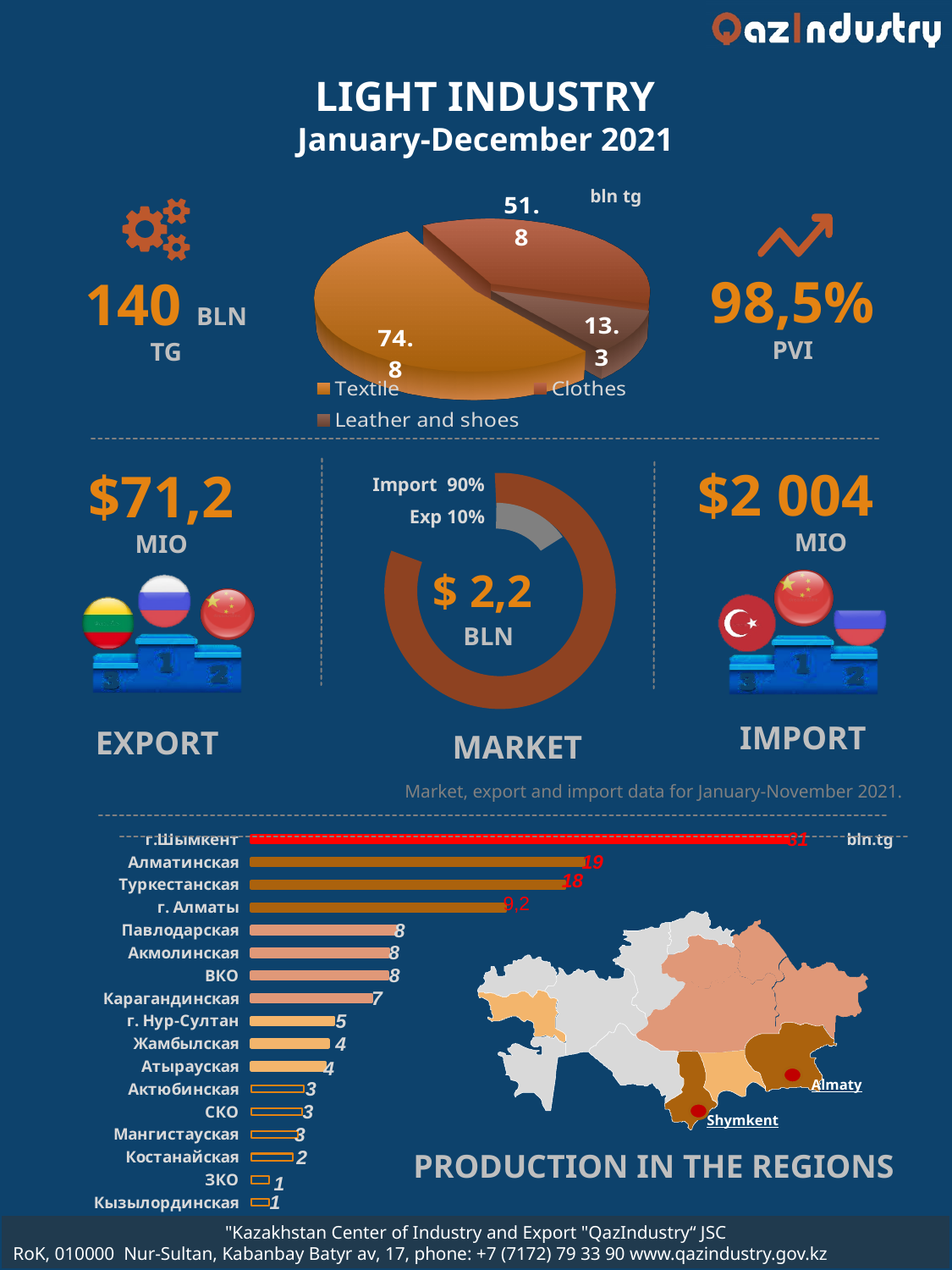
In the MARKET donut chart, what share is Exp? 10% In the pie chart at the top of the slide, how many categories does the legend list? 3 In the pie chart at the top of the slide, which category has the smallest slice? Leather and shoes In the pie chart at the top of the slide, what is the value for Leather and shoes? 13.3 In the pie chart at the top of the slide, what is the value for Textile? 74.8 What kind of chart is the PRODUCTION IN THE REGIONS chart? bar chart In the MARKET donut chart, what share is Import? 90% In the PRODUCTION IN THE REGIONS chart, which region has the highest value? г.Шымкент In the PRODUCTION IN THE REGIONS chart, what is the value for г. Алматы? 9,2 In the pie chart at the top of the slide, which category has the largest slice? Textile In the PRODUCTION IN THE REGIONS chart, what is the difference between Туркестанская and Карагандинская? 11 In the PRODUCTION IN THE REGIONS chart, what is the value for Алматинская? 19